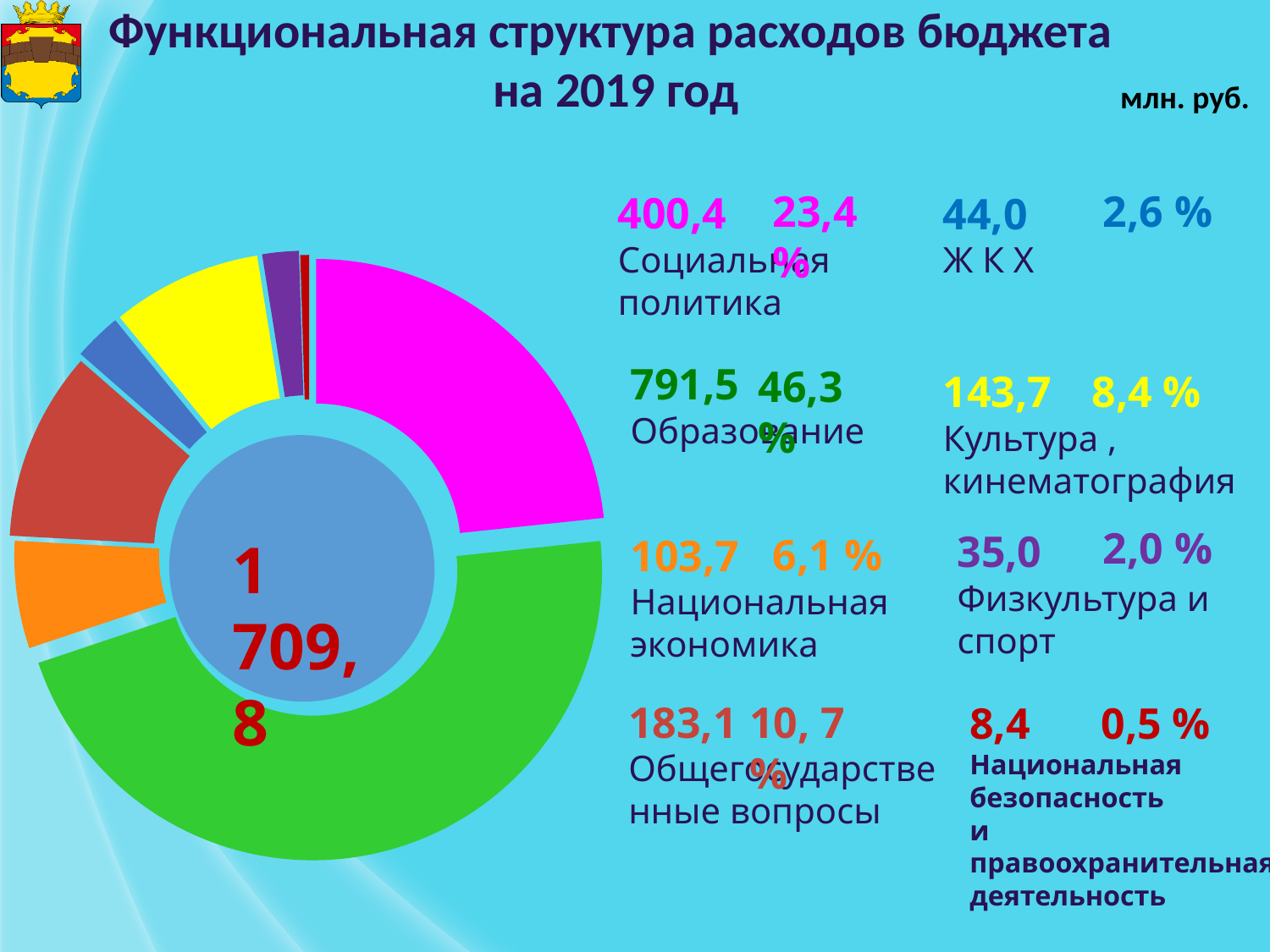
What is the value for Образование? 791,5 What share of the budget does Общегосударственные вопросы account for? 10, 7 % What unit is stated for the values on the slide? млн. руб. Which category has the smallest expenditure? Национальная безопасность и правоохранительная деятельность How many expenditure categories are shown in the chart? 8 What kind of chart is shown on the slide? doughnut (pie) chart Which category has the largest expenditure? Образование What is the difference between the values for Образование and Социальная политика? 391,1 What is the value for Социальная политика? 400,4 What total value is shown in the centre of the chart? 1 709,8 What share of the budget does Культура, кинематография account for? 8,4 % Which is larger, the value for Национальная экономика or the value for ЖКХ? Национальная экономика